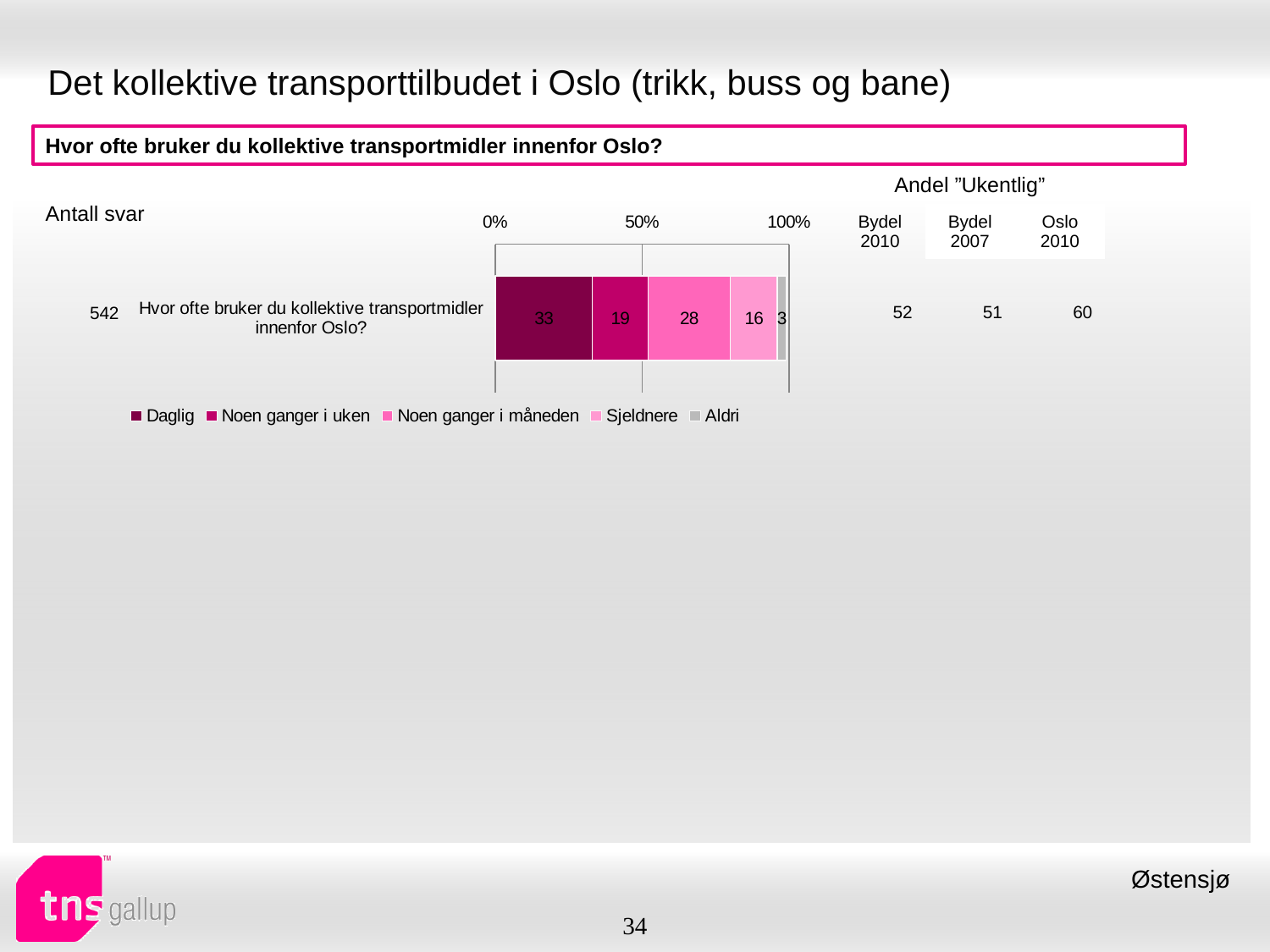
What value is shown for the "Sjeldnere" segment? 16 Which is larger, the "Noen ganger i måneden" value or the "Sjeldnere" value? Noen ganger i måneden What value is shown for the "Noen ganger i måneden" segment? 28 How many series does the legend list? 5 What value is shown for the "Noen ganger i uken" segment? 19 What value is shown for the "Daglig" segment of the bar? 33 Which segment of the bar has the smallest value? Aldri What kind of chart is shown on the slide? Stacked bar chart What is the total of the "Daglig" and "Noen ganger i uken" segments combined? 52 Which segment of the bar has the largest value? Daglig What value is shown for the "Aldri" segment? 3 What is the difference between the "Daglig" and "Noen ganger i uken" values? 14